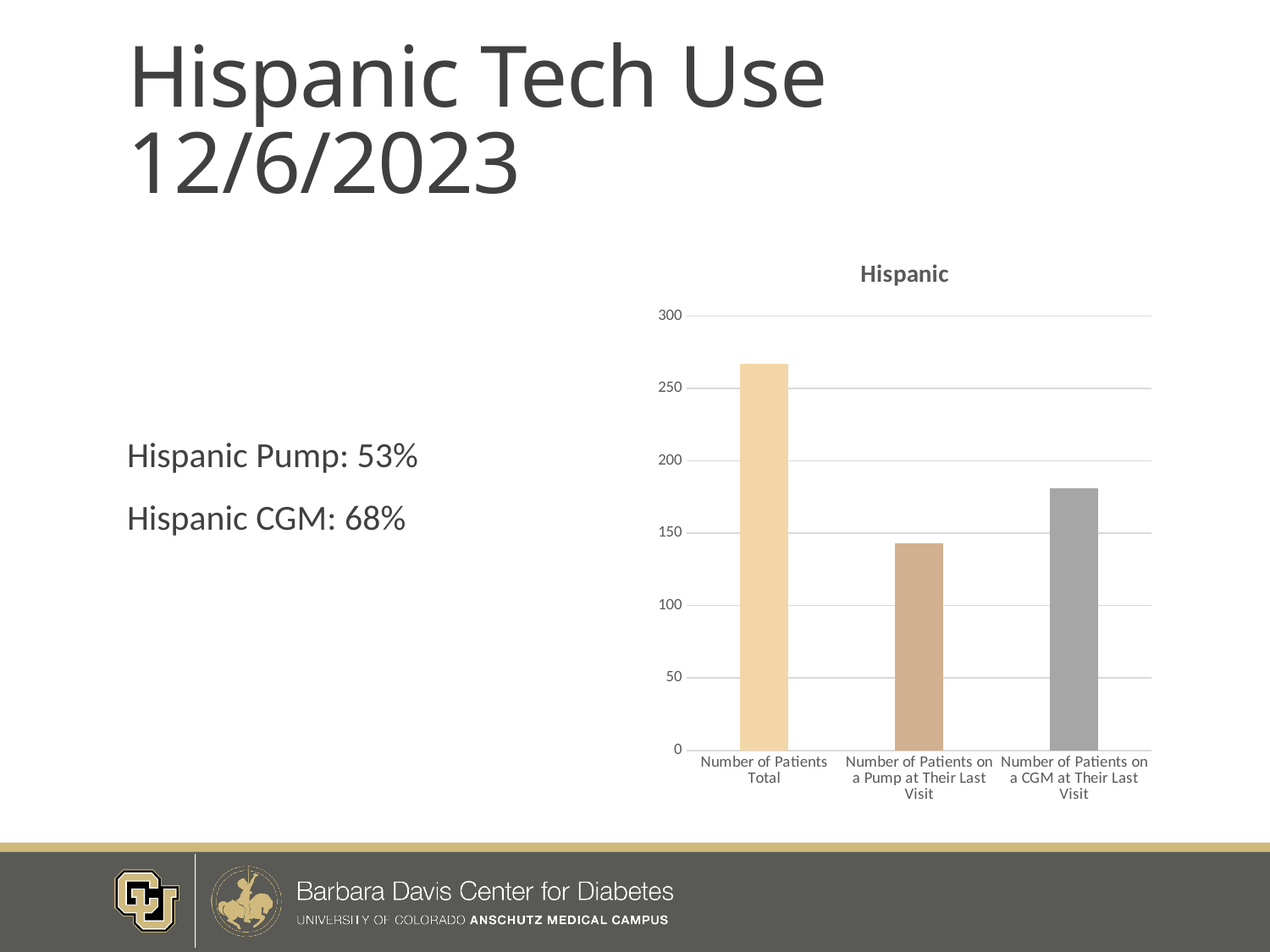
Is the value for Number of Patients Total greater or less than 300? less Is the value for Number of Patients on a Pump at Their Last Visit greater or less than 100? greater What colour is the bar for Number of Patients on a CGM at Their Last Visit? gray Is the value for Number of Patients on a CGM at Their Last Visit greater or less than 200? less What kind of chart is shown on the slide? bar chart Which category has the lowest value in the chart? Number of Patients on a Pump at Their Last Visit Which category has the highest value in the chart? Number of Patients Total Which is larger: the value for Number of Patients on a CGM at Their Last Visit or the value for Number of Patients on a Pump at Their Last Visit? Number of Patients on a CGM at Their Last Visit How many categories are plotted in the chart? 3 What is the title of the chart? Hispanic